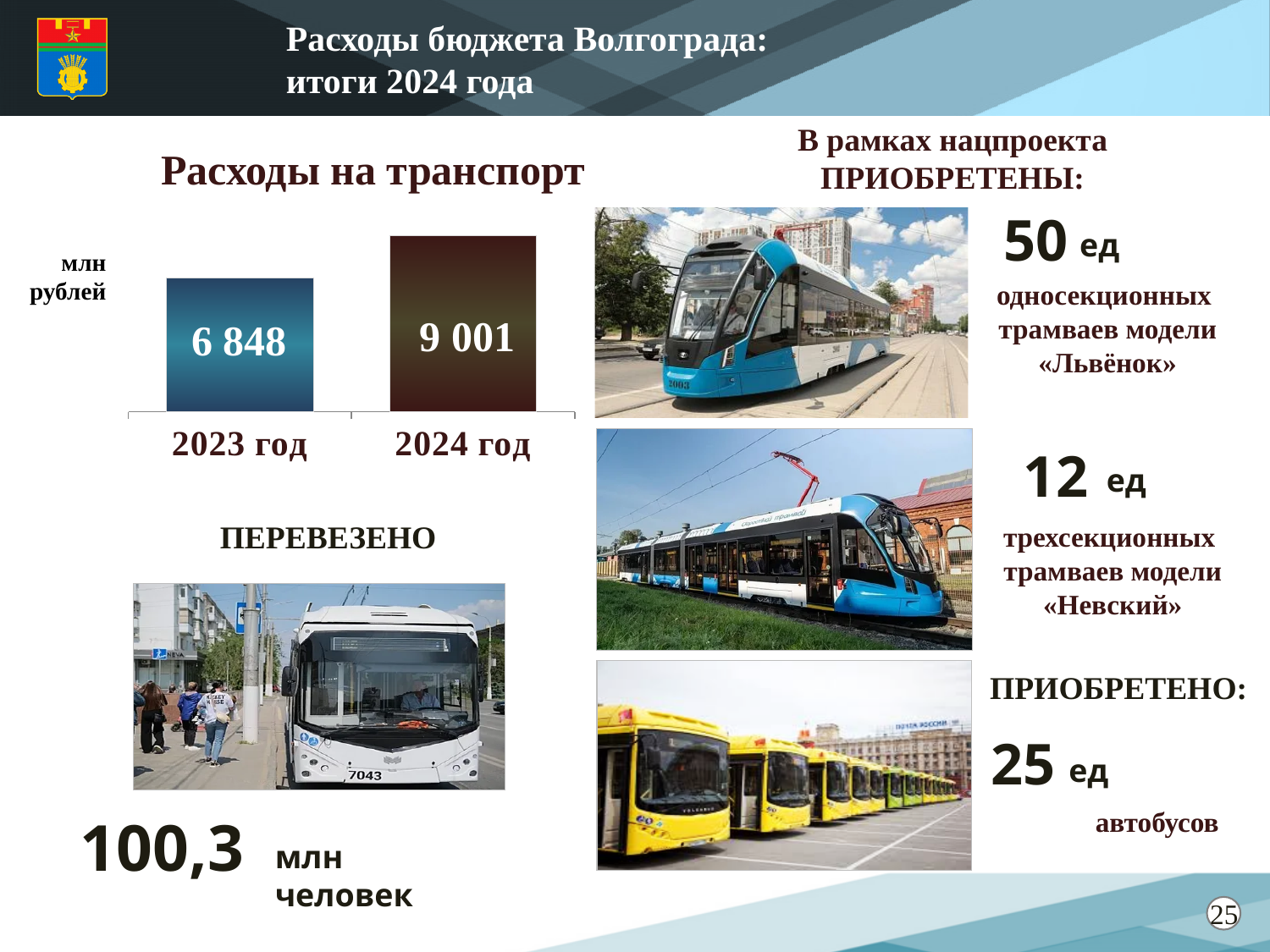
What is the value for 2023 год in the chart "Расходы на транспорт"? 6 848 What unit is indicated for the values in the chart "Расходы на транспорт"? млн рублей In the chart "Расходы на транспорт", is the value for 2024 год larger or smaller than the value for 2023 год? larger Which year has the higher value in the chart "Расходы на транспорт"? 2024 год What is the title of the bar chart on the slide? Расходы на транспорт What is the difference between the 2024 год and 2023 год values in the chart "Расходы на транспорт"? 2 153 What is the value for 2024 год in the chart "Расходы на транспорт"? 9 001 Do the values in the chart "Расходы на транспорт" rise or fall from 2023 год to 2024 год? rise What kind of chart is "Расходы на транспорт"? bar chart Which year has the lower value in the chart "Расходы на транспорт"? 2023 год How many categories (years) are shown in the chart "Расходы на транспорт"? 2